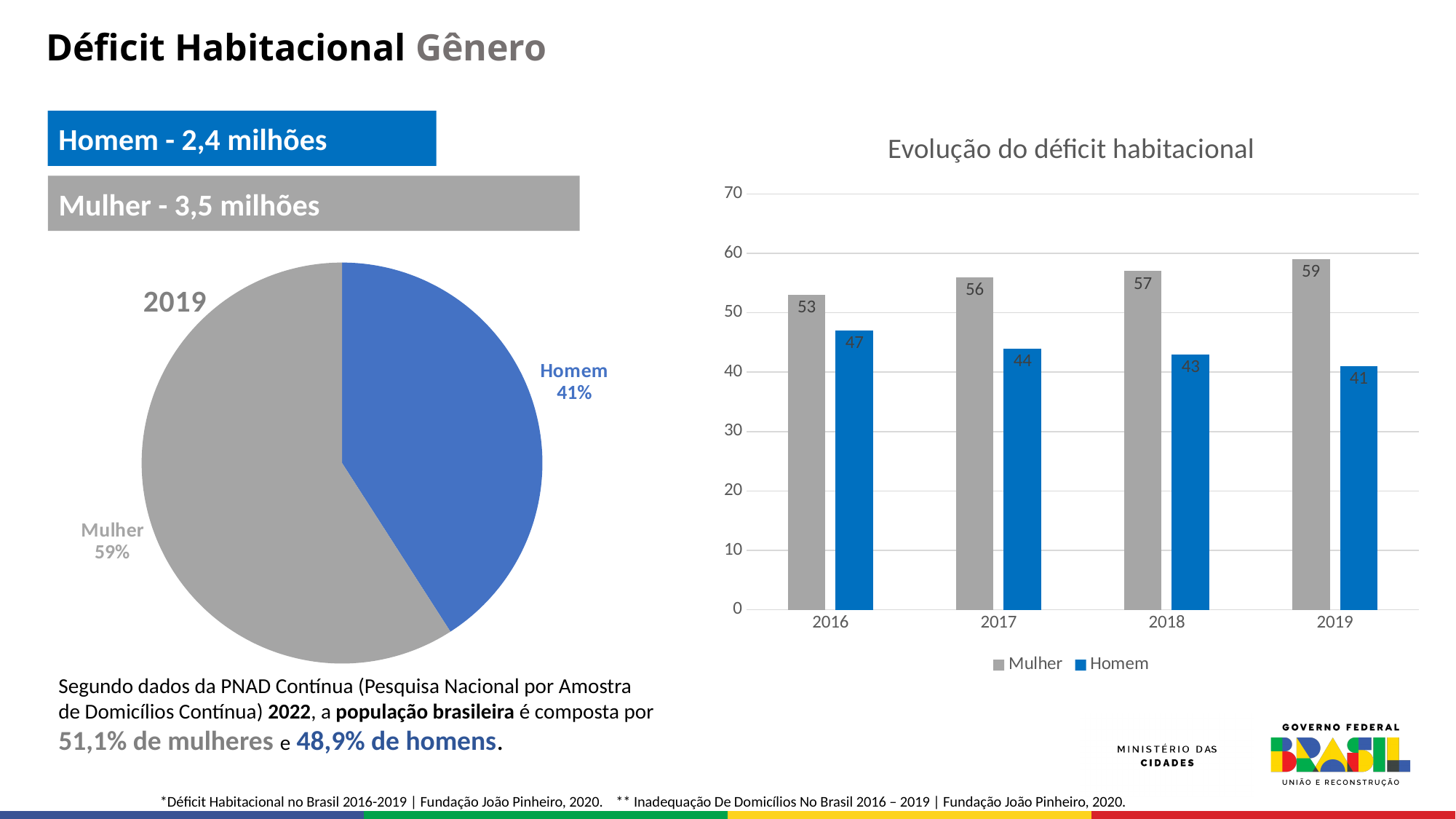
In the 'Evolução do déficit habitacional' bar chart, how many years are shown on the x axis? 4 In the 2019 pie chart, what share does Mulher have? 59% In the 'Evolução do déficit habitacional' bar chart, what colour are the Homem bars? blue In the 'Evolução do déficit habitacional' bar chart, how many series does the legend list? 2 In the 'Evolução do déficit habitacional' bar chart, which is larger in 2017, Mulher or Homem? Mulher In the 'Evolução do déficit habitacional' bar chart, which year has the highest value for Mulher? 2019 In the 'Evolução do déficit habitacional' bar chart, what is the value for Mulher in 2019? 59 In the 'Evolução do déficit habitacional' bar chart, what is the difference between Mulher and Homem in 2018? 14 In the 'Evolução do déficit habitacional' bar chart, which year has the lowest value for Homem? 2019 What kind of chart is the chart on the left of the slide labelled 2019? pie chart In the 'Evolução do déficit habitacional' bar chart, do the values for Homem rise or fall from 2016 to 2019? fall In the 'Evolução do déficit habitacional' bar chart, what is the value for Homem in 2016? 47